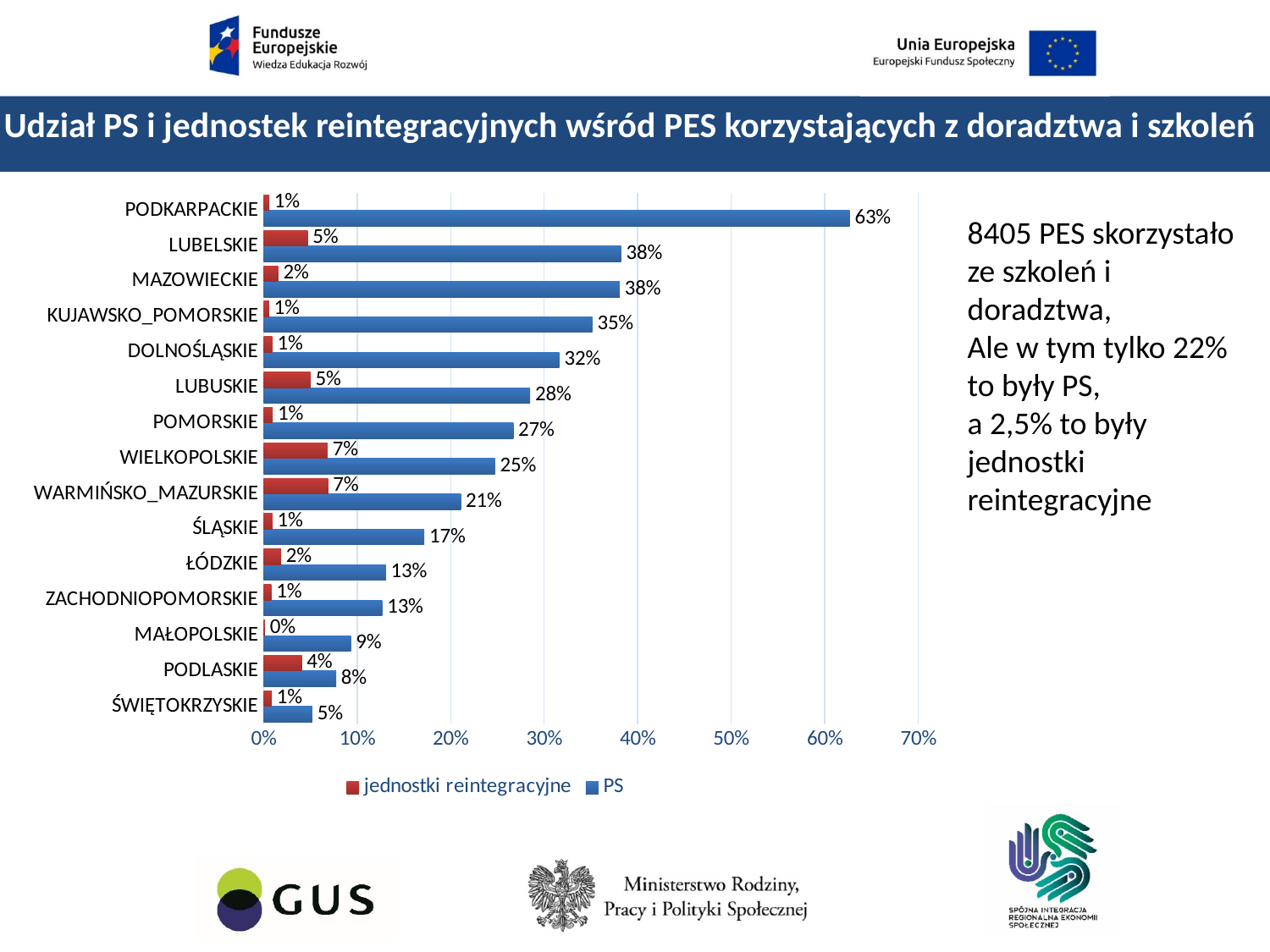
How many series does the legend list? 2 What is the value of jednostki reintegracyjne for WIELKOPOLSKIE? 7% Which region has the highest PS value? PODKARPACKIE What type of chart is shown on the slide? Bar chart Which series is shown in red in the legend? jednostki reintegracyjne What is the PS value for LUBUSKIE? 28% What is the difference between the PS values for PODKARPACKIE and LUBELSKIE? 25% Which region has the lowest PS value? ŚWIĘTOKRZYSKIE Which is larger, the PS value for DOLNOŚLĄSKIE or for POMORSKIE? DOLNOŚLĄSKIE Which region has the lowest value for jednostki reintegracyjne? MAŁOPOLSKIE What is the PS value for PODKARPACKIE? 63% How many regions are shown on the chart? 15